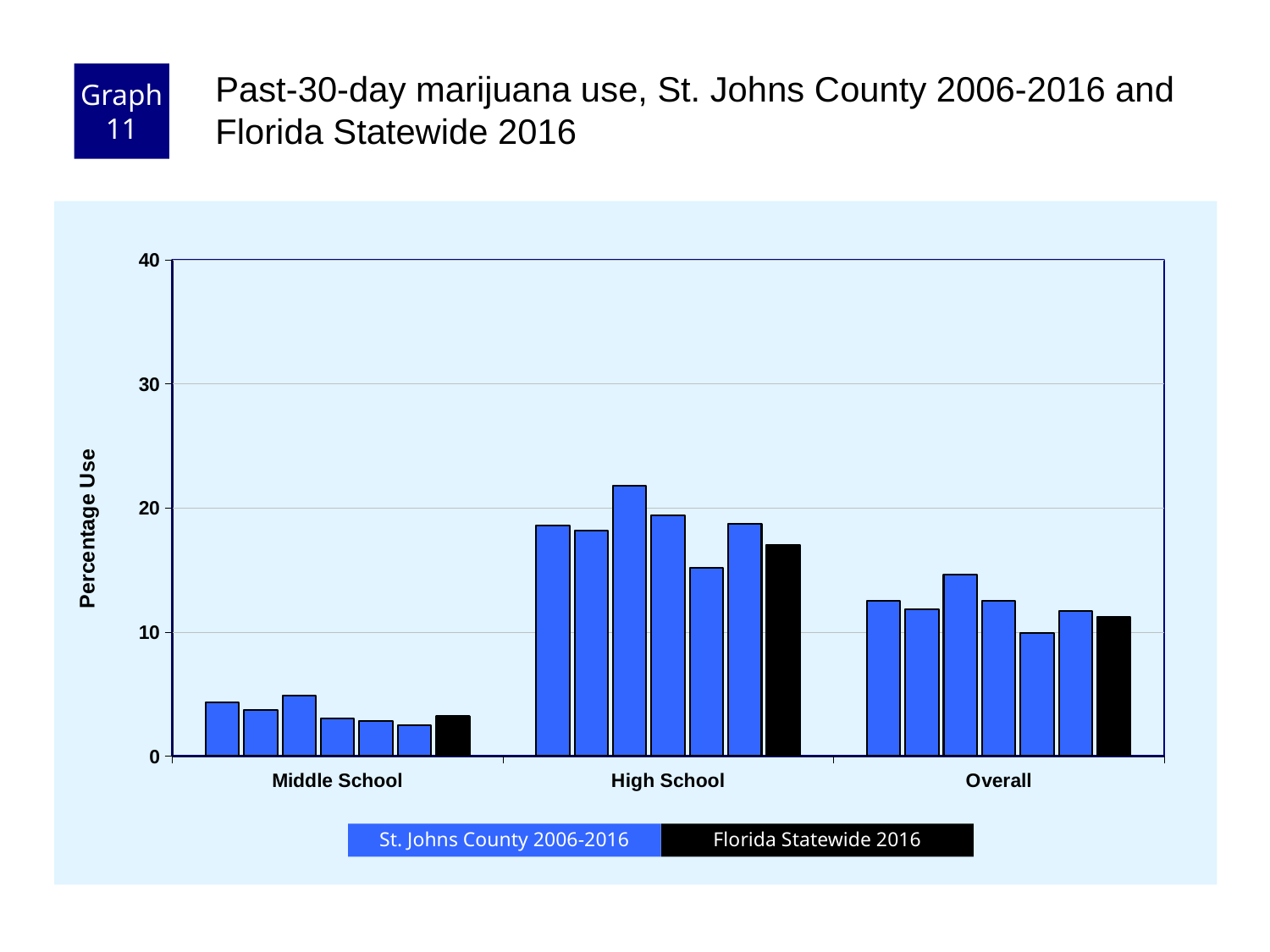
How many categories are shown on the x axis? 3 Is the Florida Statewide 2016 value for High School greater or less than 20? less Is the Florida Statewide 2016 value for High School greater or less than 10? greater Which category has the highest bars overall? High School Is the Florida Statewide 2016 value for Middle School greater or less than 10? less Is the Florida Statewide 2016 value larger for High School or for Overall? High School What is the label of the y axis? Percentage Use How many series does the legend list? 2 Which category has the lowest bars overall? Middle School Which colour represents Florida Statewide 2016 in the legend? black What kind of chart is shown on the slide? bar chart